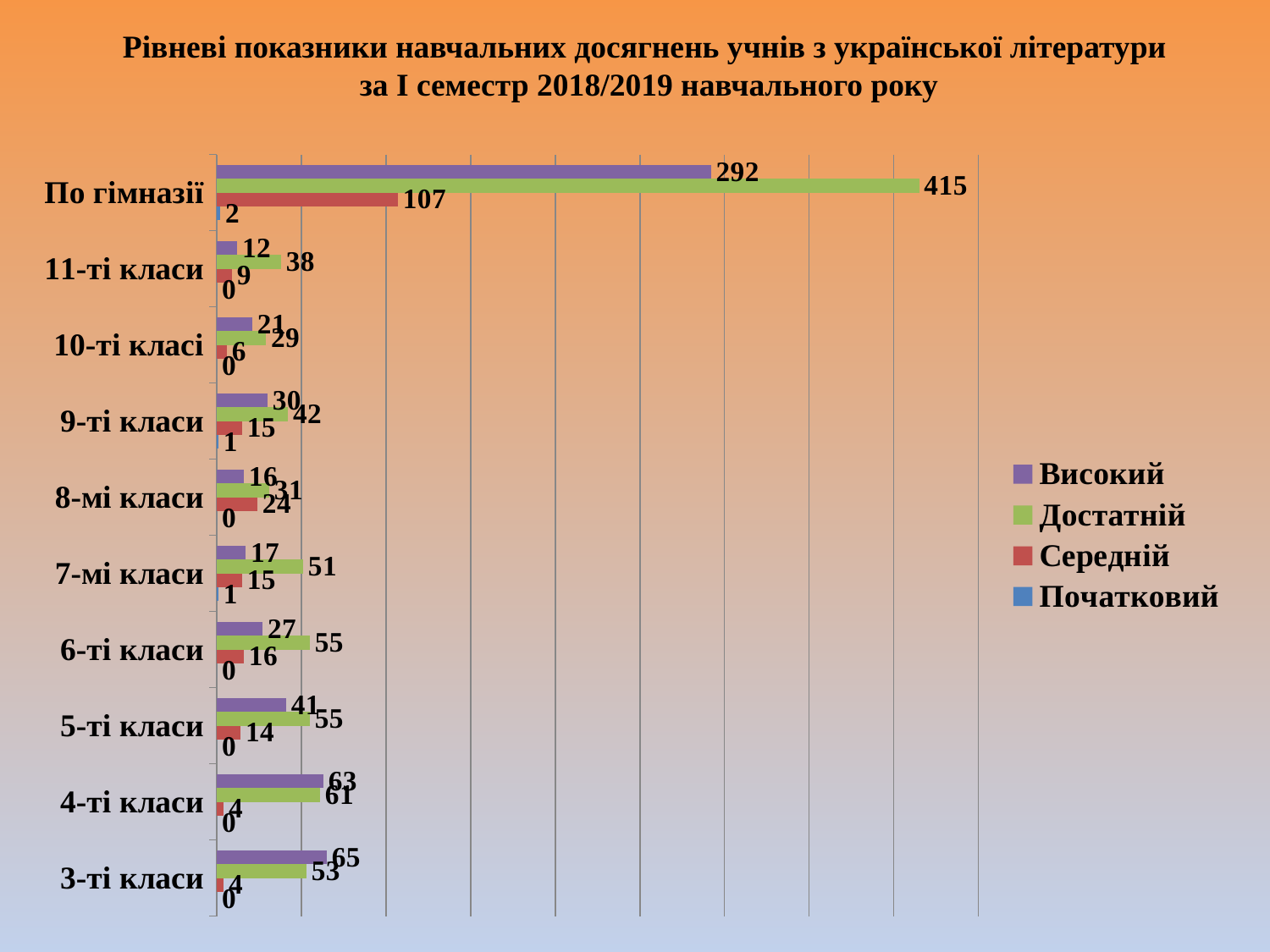
How many categories are shown on the vertical axis? 10 What is the difference between the Достатній and Високий values for По гімназії? 123 What is the value of Високий for 4-ті класи? 63 What is the value of Середній for 8-мі класи? 24 What type of chart is shown on the slide? bar chart Which series is shown in green in the legend? Достатній How many series does the legend list? 4 Among the class categories (excluding По гімназії), which has the highest Високий value? 3-ті класи Among the class categories (excluding По гімназії), which has the lowest Достатній value? 10-ті класі What is the value of Достатній for По гімназії? 415 What is the value of Початковий for 9-ті класи? 1 Which is larger for 7-мі класи: the Достатній value or the Високий value? Достатній